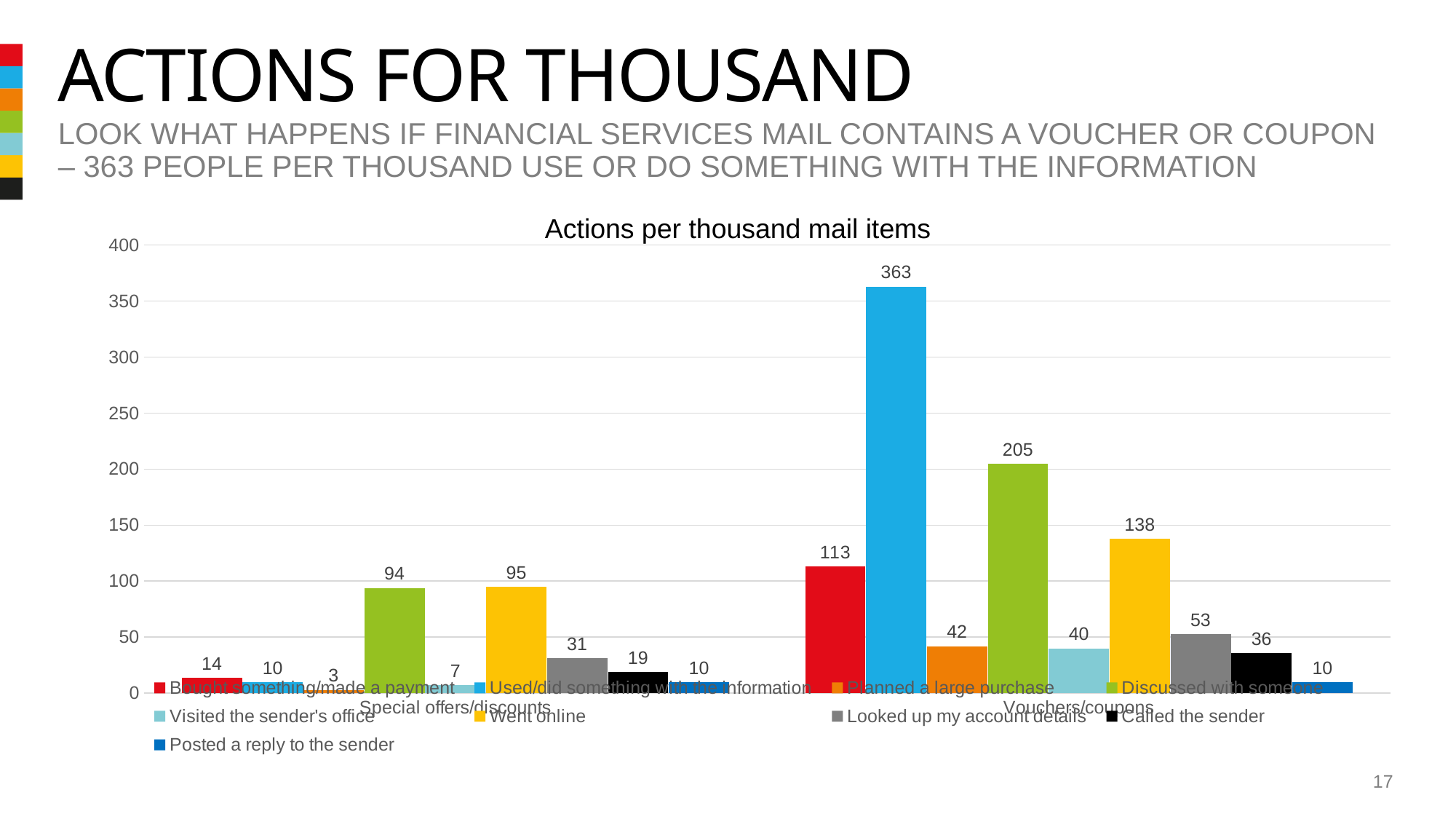
How many series does the legend list? 9 What kind of chart is shown on the slide? Bar chart How many categories are shown on the x axis? 2 What is the value for 'Used/did something with the information' in the Vouchers/coupons category? 363 Which is larger: 'Looked up my account details' for Vouchers/coupons or 'Called the sender' for Vouchers/coupons? Looked up my account details What is the title of the chart? Actions per thousand mail items Which series has the lowest value in the Special offers/discounts category? Planned a large purchase Which series has the highest value in the Vouchers/coupons category? Used/did something with the information What is the value for 'Went online' in the Vouchers/coupons category? 138 What is the value for 'Discussed with someone' in the Special offers/discounts category? 94 What is the value for 'Planned a large purchase' in the Special offers/discounts category? 3 What is the difference between 'Bought something/made a payment' for Vouchers/coupons and for Special offers/discounts? 99